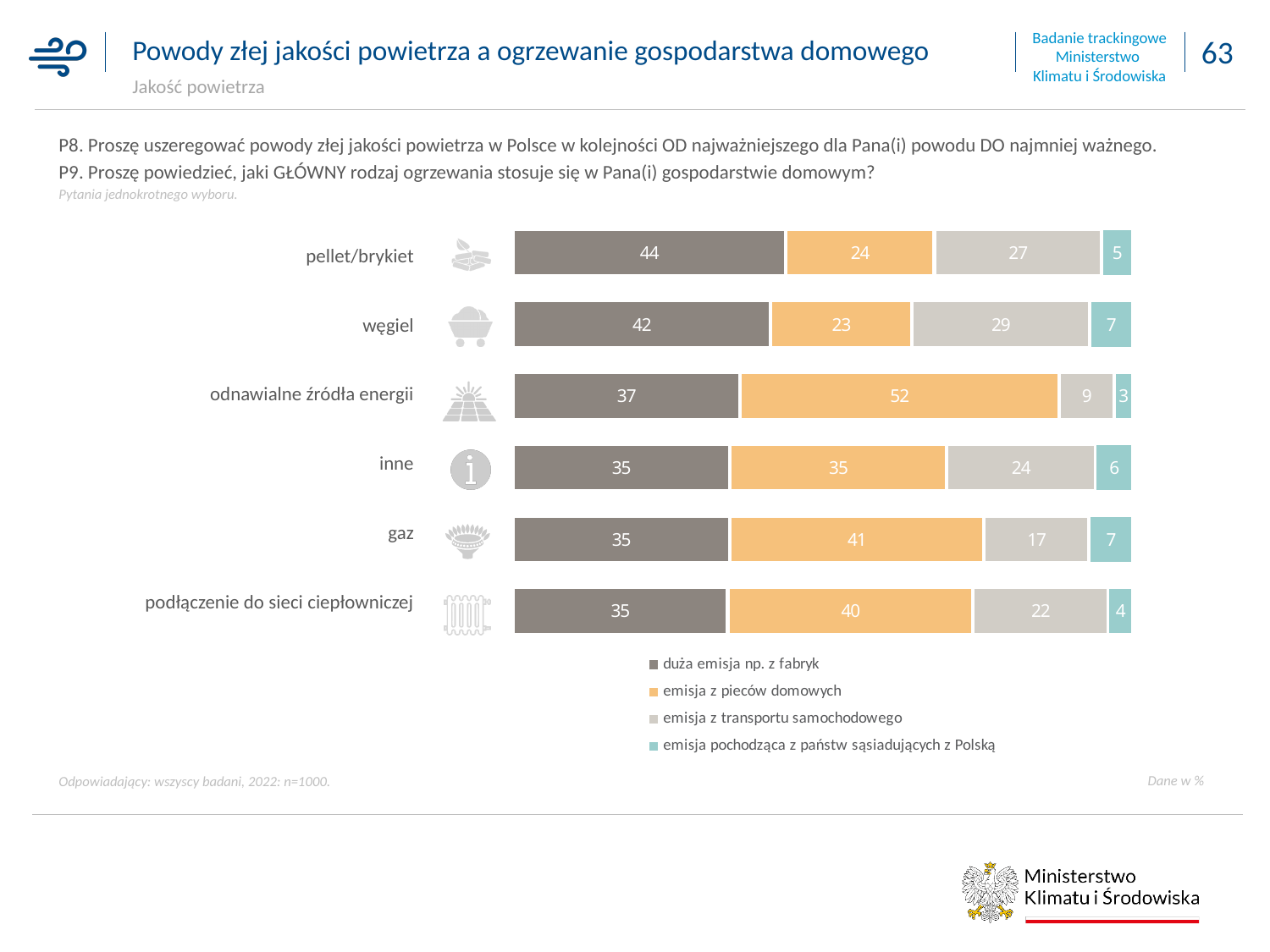
What is the total of the stacked bar for inne? 100 Which category has the lowest value for 'emisja z transportu samochodowego'? odnawialne źródła energii What is the value of 'duża emisja np. z fabryk' for pellet/brykiet? 44 What is the value of 'emisja z pieców domowych' for odnawialne źródła energii? 52 Which category has the highest value for 'duża emisja np. z fabryk'? pellet/brykiet Which is larger: the 'emisja z pieców domowych' value for gaz or for inne? gaz What is the difference between the 'emisja z pieców domowych' values for odnawialne źródła energii and pellet/brykiet? 28 What type of chart is shown on the slide? stacked bar chart What is the value of 'emisja z transportu samochodowego' for węgiel? 29 What is the value of 'emisja pochodząca z państw sąsiadujących z Polską' for gaz? 7 How many heating-type categories are shown in the chart? 6 How many series does the legend list? 4